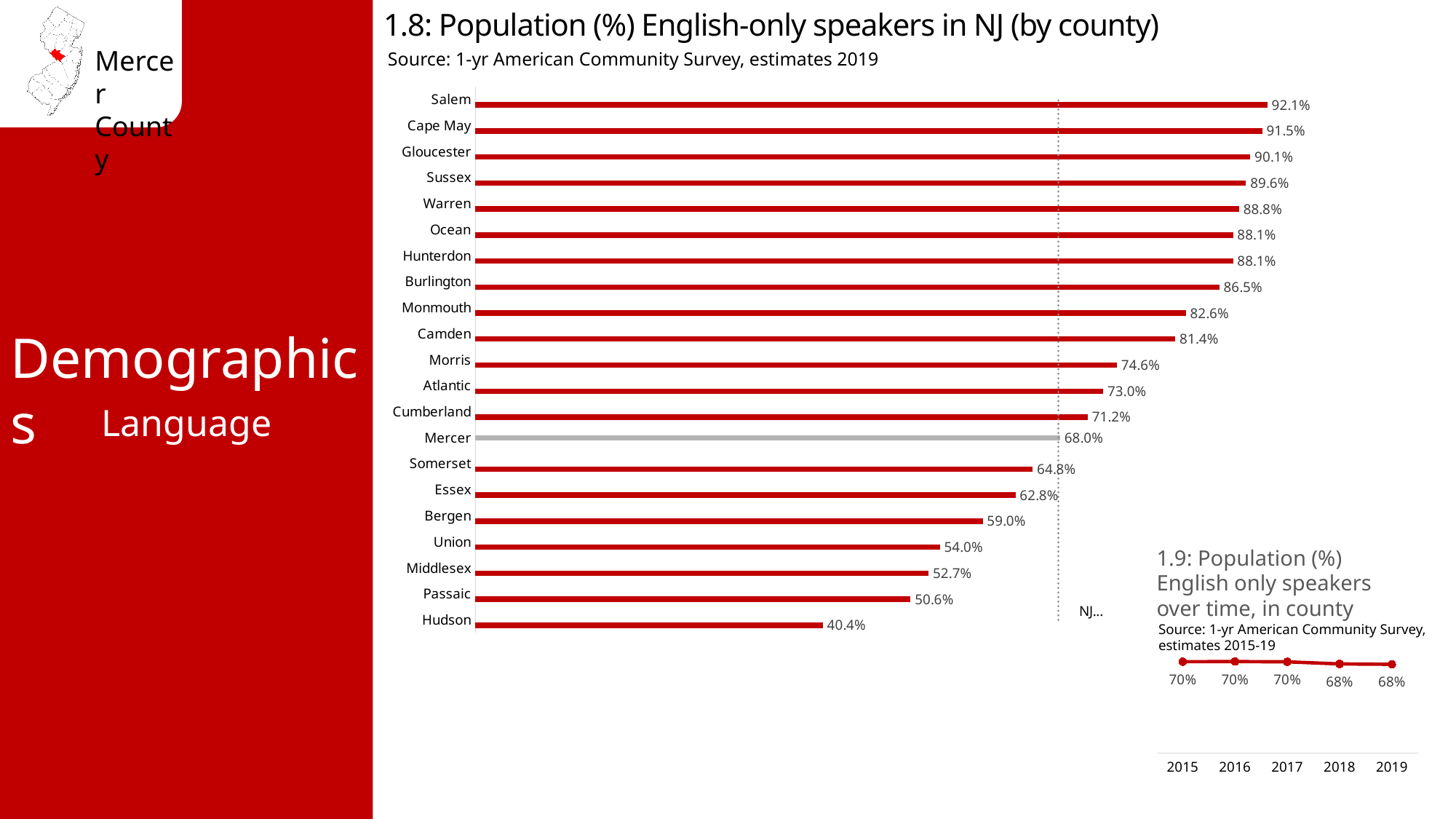
In chart 1.8, what is the difference between the values for Salem and Hudson? 51.7% In chart 1.8, which county has the highest percentage of English-only speakers? Salem In chart 1.9, what is the value for 2019? 68% In chart 1.8, what is the value for Hudson? 40.4% In chart 1.8, which county has the lowest percentage of English-only speakers? Hudson In chart 1.9, do the values rise or fall from 2015 to 2019? Fall In chart 1.9, how many years are plotted? 5 In chart 1.8, which is larger, the value for Morris or the value for Atlantic? Morris In chart 1.8, what is the value for Mercer? 68.0% In chart 1.8, which county's bar is shown in grey instead of red? Mercer In chart 1.8, how many counties are plotted? 21 What kind of chart is chart 1.8? Bar chart